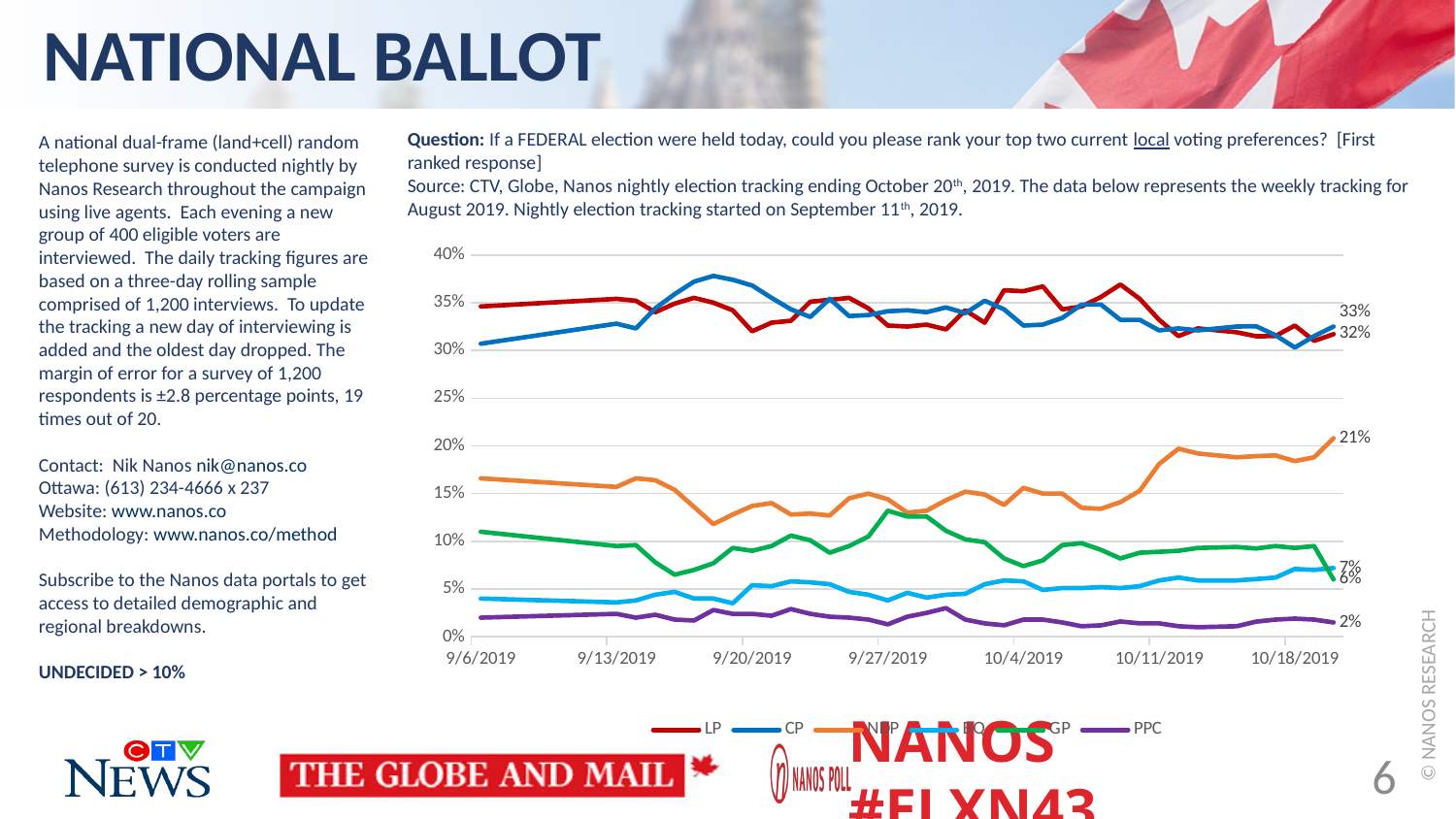
How many series does the chart legend list? 6 What is the final labelled value for the PPC series? 2% What is the difference between the final labelled values of the NDP and PPC series? 19 percentage points What type of chart is shown on the slide? line chart Which series has the highest value at the end of the tracking period? CP At the end of the tracking period, which series has the higher labelled value, CP or LP? CP What is the final labelled value for the NDP series? 21% What is the final labelled value for the LP series? 32% Which series has the lowest value at the end of the tracking period? PPC How many date labels are shown on the x axis? 7 Is the value for the NDP series at 9/6/2019 greater or less than 15%? greater What is the final labelled value for the CP series? 33%